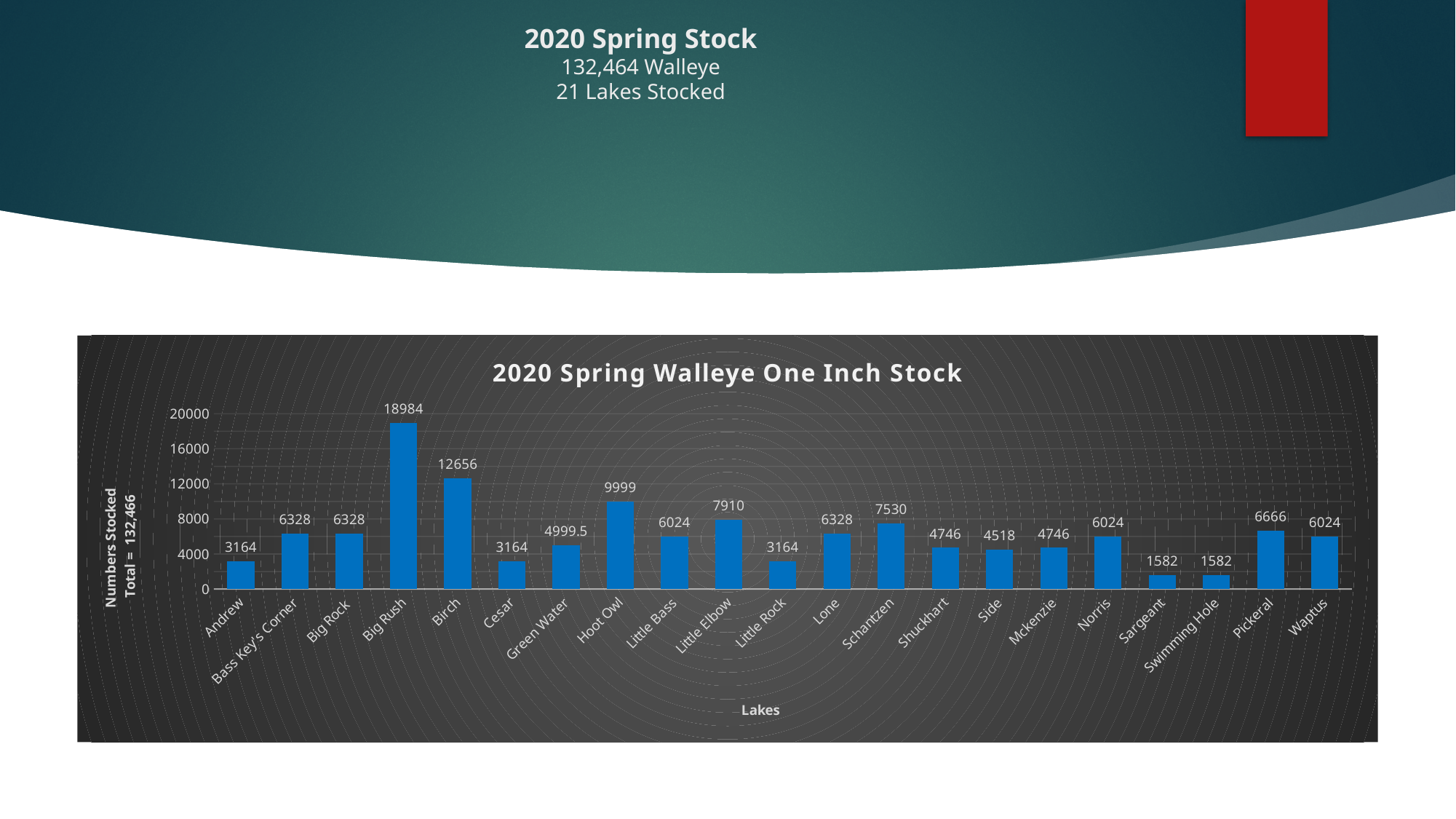
Which lake has the highest number stocked? Big Rush What is the lowest value shown on the chart? 1582 What is the value for Schantzen? 7530 What is the label of the x axis? Lakes What is the difference between the values for Big Rush and Birch? 6328 What is the value for Green Water? 4999.5 What type of chart is shown on the slide? Bar chart What is the value for Big Rush? 18984 How many lakes are shown on the x axis of the chart? 21 What is the title of the chart? 2020 Spring Walleye One Inch Stock Which is larger, the value for Hoot Owl or the value for Little Elbow? Hoot Owl What is the value for Pickeral? 6666